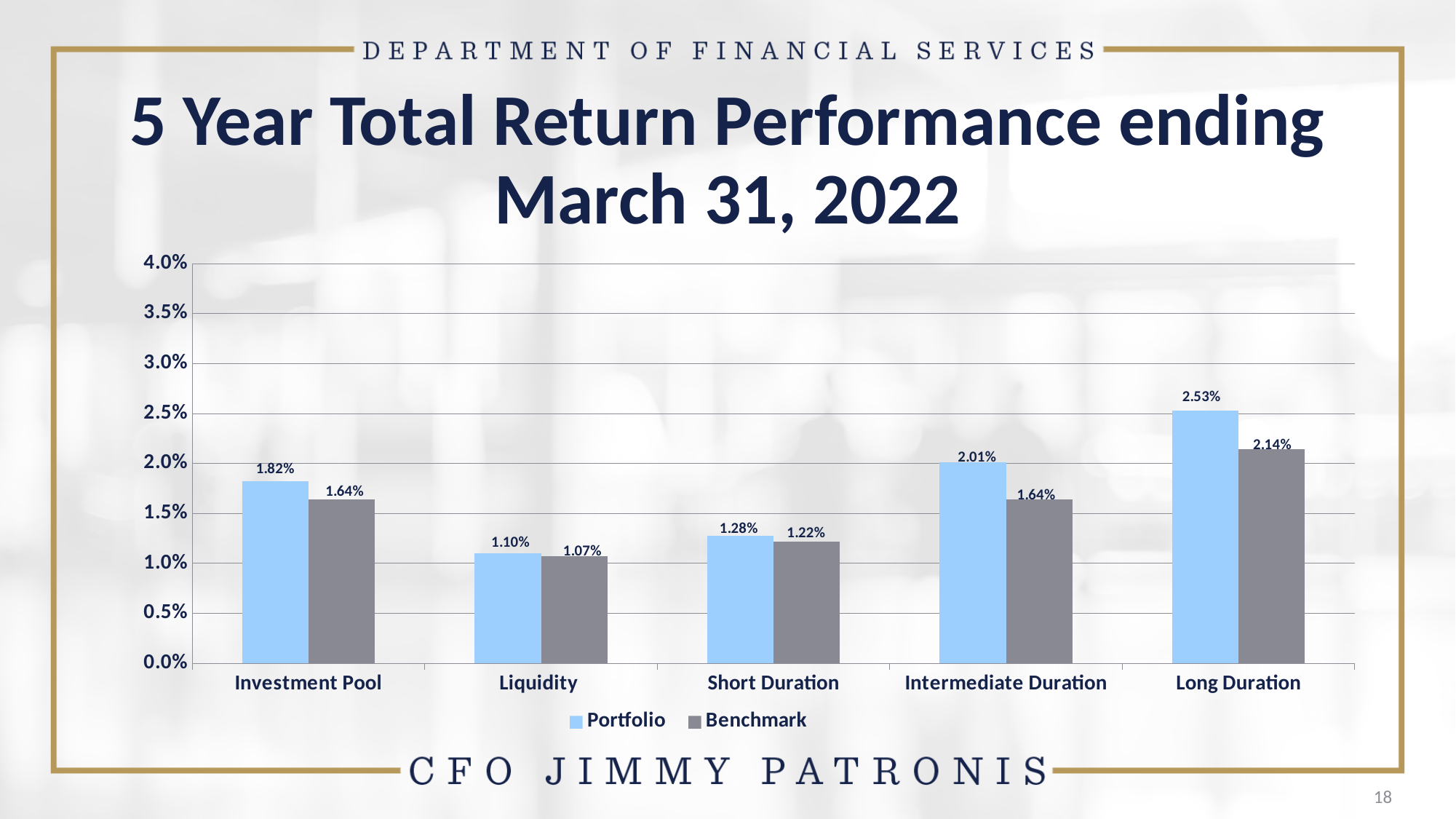
Which category has the lowest Benchmark value? Liquidity How many categories are shown on the x axis? 5 What kind of chart is shown on the slide? Bar chart What colour represents the Benchmark series? Grey What is the difference between the Portfolio and Benchmark values for Intermediate Duration? 0.37% Which category has the highest Portfolio value? Long Duration What is the Portfolio value for Short Duration? 1.28% Which is larger for Liquidity, the Portfolio value or the Benchmark value? Portfolio Is the Portfolio value for Long Duration greater or less than 2.0%? greater How many series does the legend list? 2 What is the Portfolio value for Investment Pool? 1.82% What is the Benchmark value for Long Duration? 2.14%